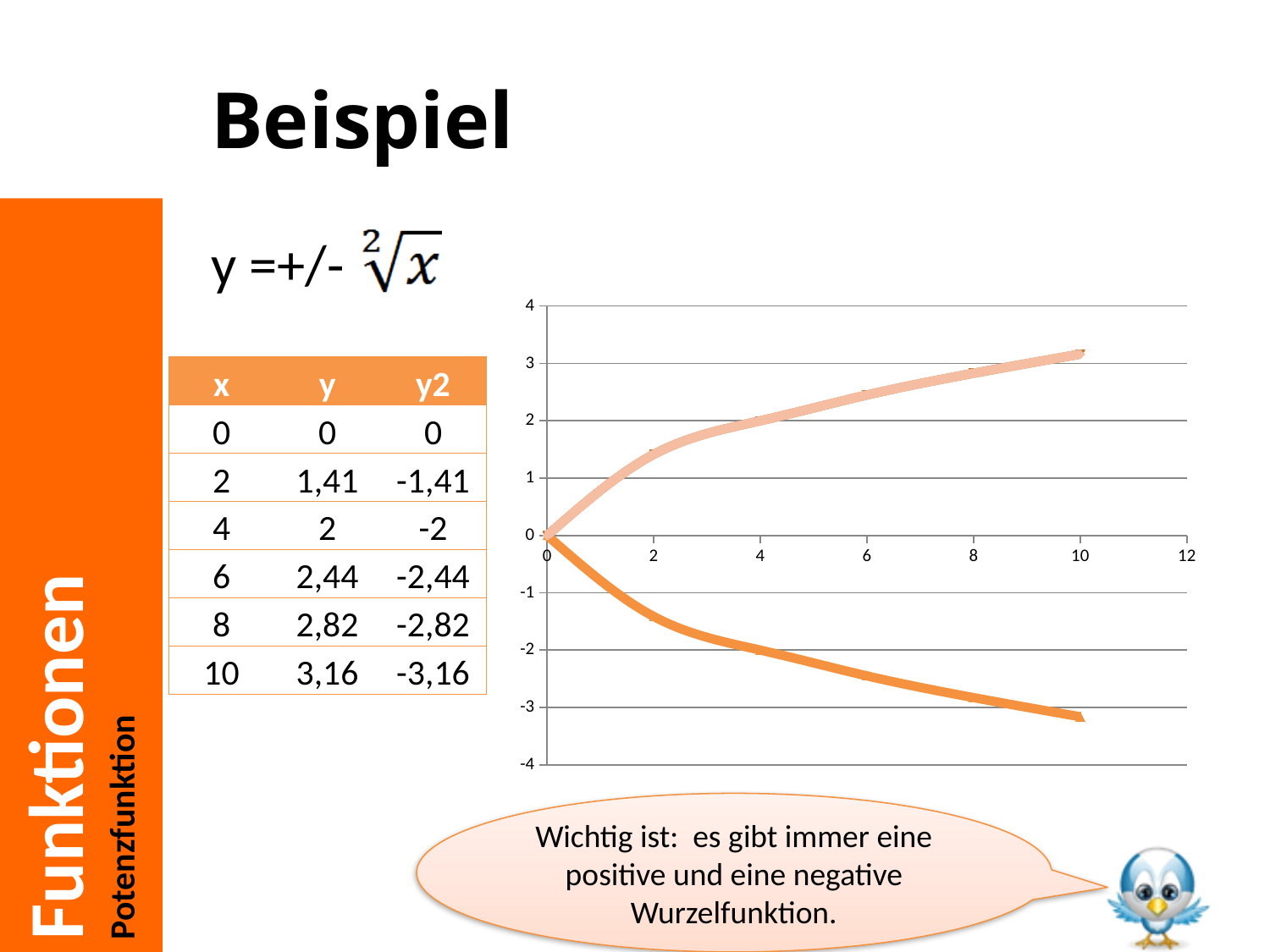
What is the highest value shown on the vertical axis of the chart? 4 Is the value of the upper line at x = 2 greater or less than 1? greater At x = 10, which line has the larger value, the upper line or the lower line? the upper line Is the value of the upper line at x = 10 greater or less than 3? greater Is the value of the upper line at x = 6 greater or less than 2? greater Does the lower line rise or fall as x increases from 0 to 10? fall What is the value of the upper line at x = 4? 2 Does the upper line rise or fall as x increases from 0 to 10? rise What kind of chart is shown on the slide? line chart How many lines are plotted in the chart? 2 What is the value of the lower line at x = 4? -2